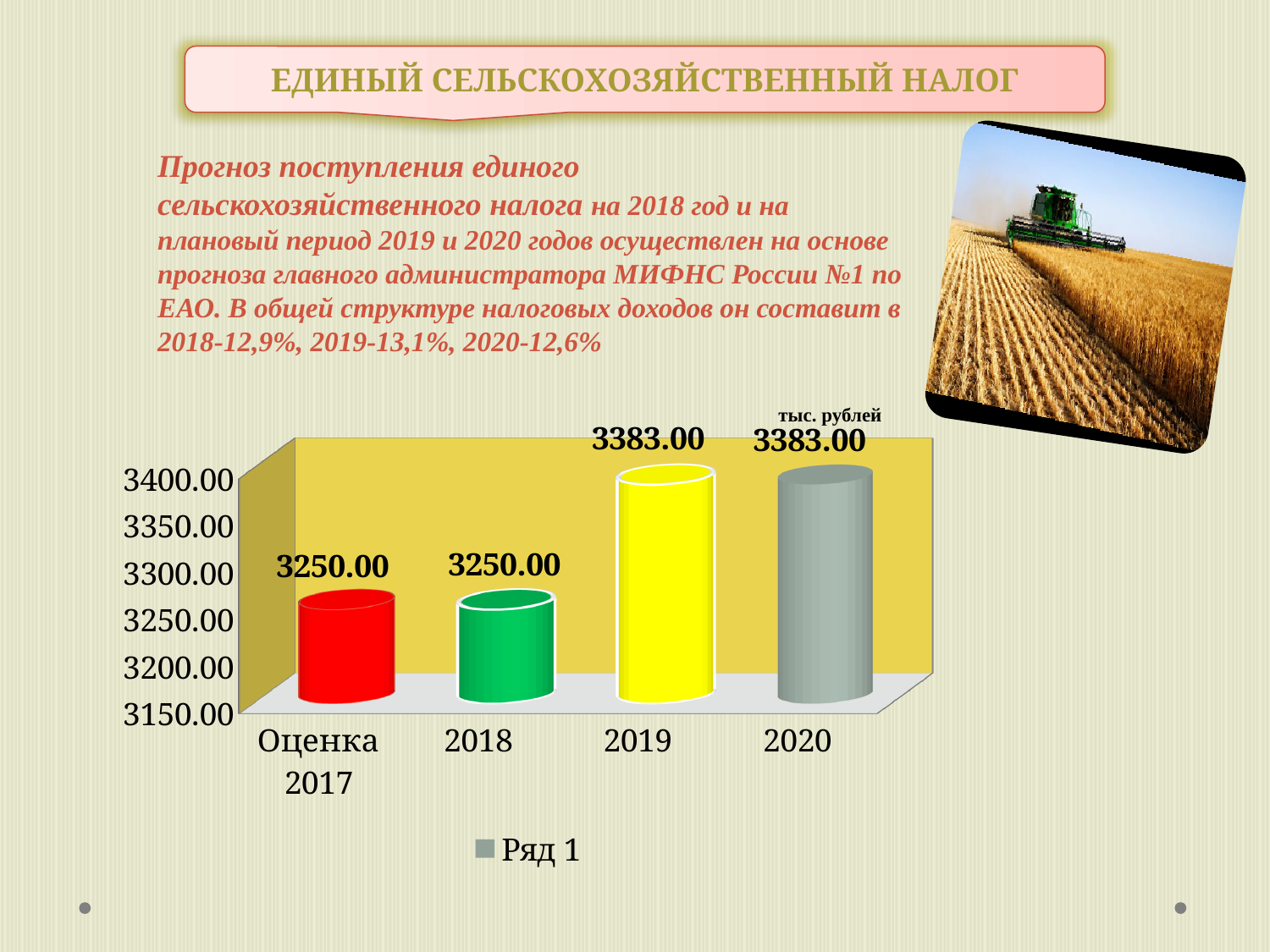
What is the value for 2018 on the chart? 3250.00 How many categories are shown on the x axis of the chart? 4 How many series does the chart legend list? 1 What is the value for 2019 on the chart? 3383.00 Is the value for 2020 greater or less than 3300.00? greater Which is larger, the value for 2018 or the value for 2019? 2019 What unit label is shown above the chart? тыс. рублей What is the value for Оценка 2017 on the chart? 3250.00 What kind of chart is shown on the slide? bar chart What is the difference between the values for 2019 and 2018? 133.00 What is the value for 2020 on the chart? 3383.00 Is the value for Оценка 2017 greater or less than 3300.00? less